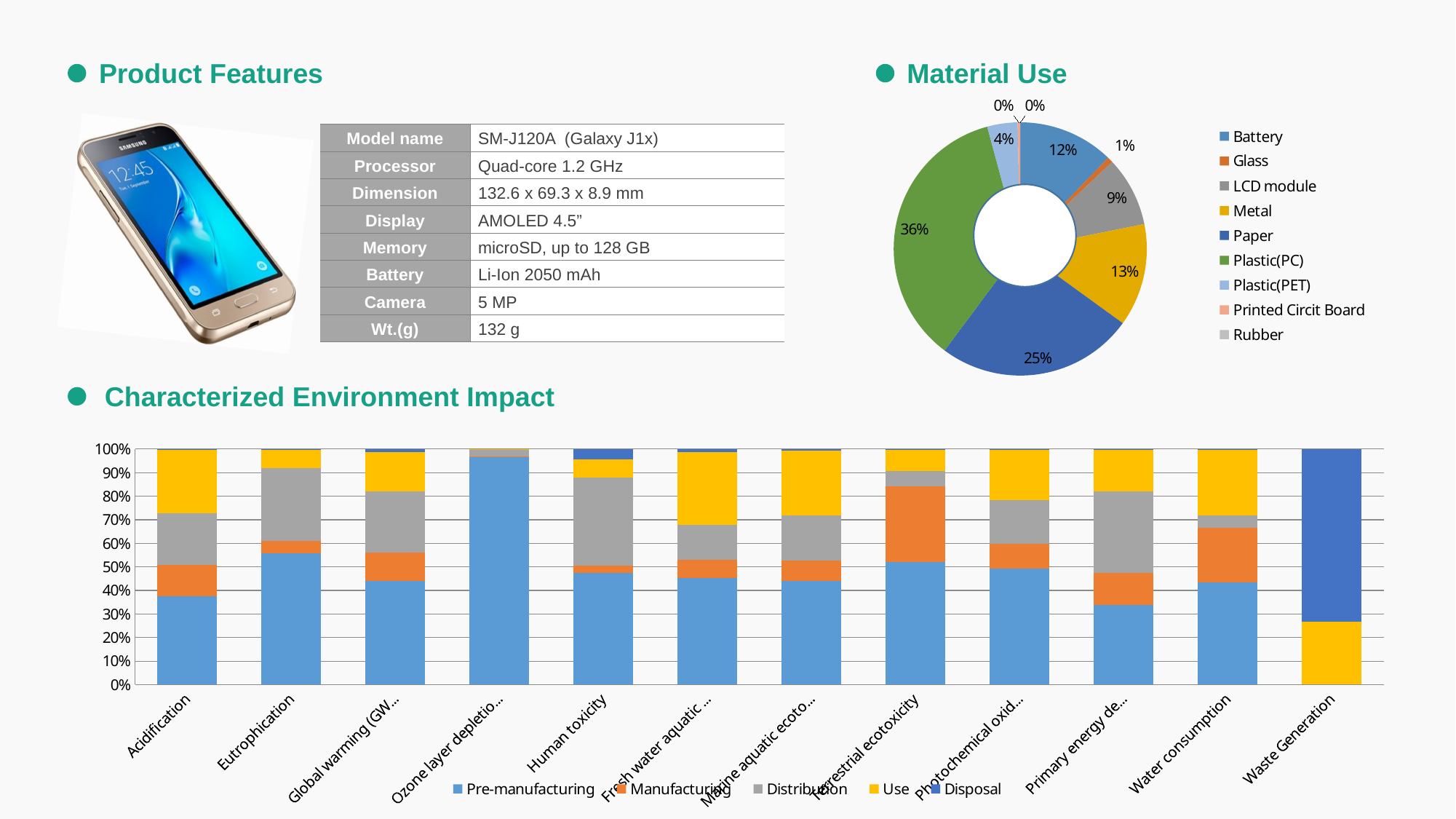
In the Characterized Environment Impact chart, is the Pre-manufacturing value for Ozone layer depletion greater or less than 90%? greater How many categories are shown on the x axis of the Characterized Environment Impact chart? 12 In the Material Use chart, what is the difference between the Paper share and the Metal share? 12% How many entries does the legend of the Material Use chart list? 9 What kind of chart is the Material Use chart? Doughnut chart In the Material Use chart, what share does Paper account for? 25% In the Material Use chart, which is larger, Metal or LCD module? Metal How many series does the legend of the Characterized Environment Impact chart list? 5 In the Material Use chart, what share does Battery account for? 12% In the Material Use chart, which material has the largest share? Plastic(PC) In the Material Use chart, what share does Plastic(PC) account for? 36% In the Characterized Environment Impact chart, is the Use value for Waste Generation greater or less than 40%? less